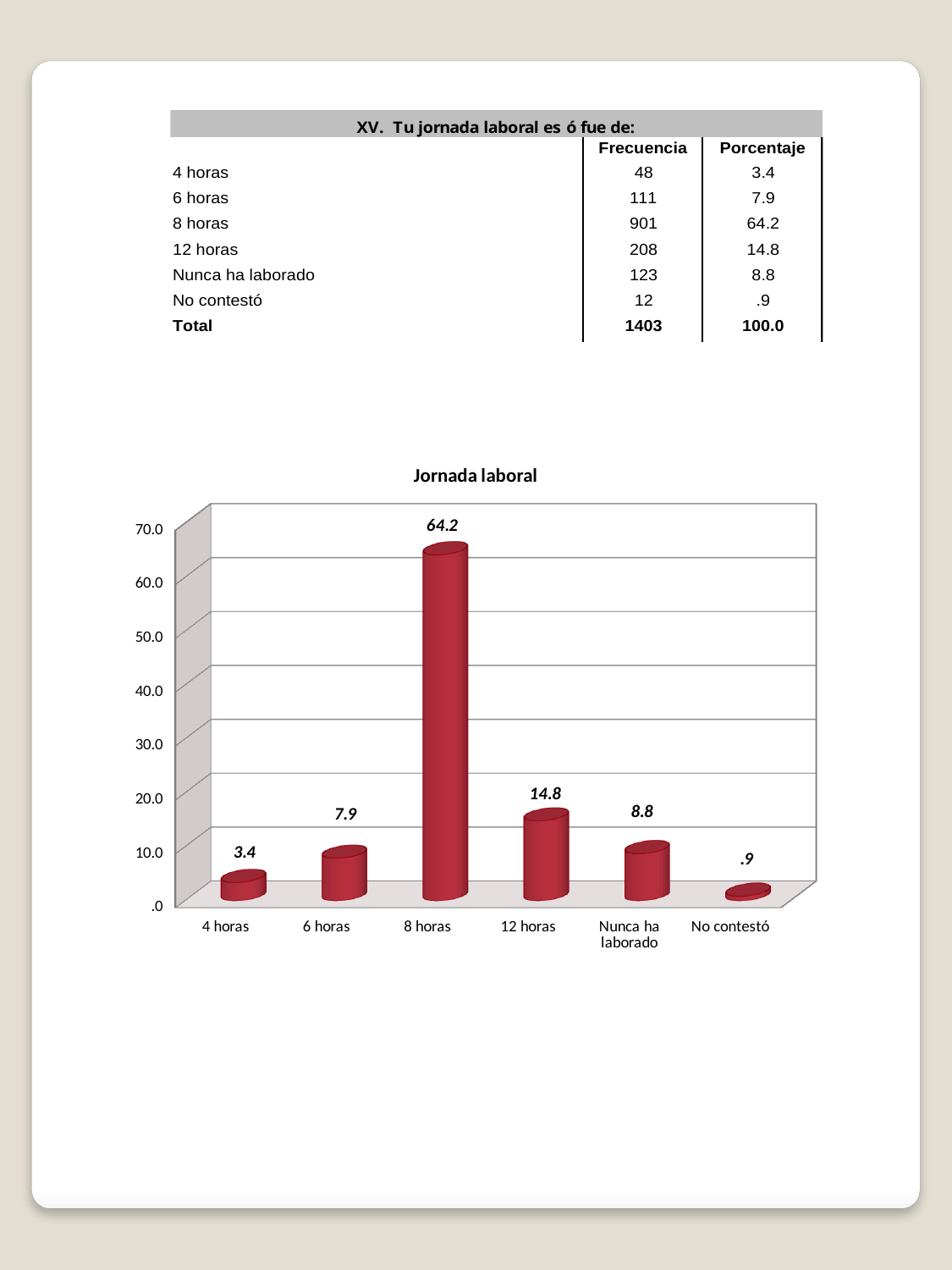
What is the value for Nunca ha laborado in the Jornada laboral chart? 8.8 Which category has the lowest value in the Jornada laboral chart? No contestó Is the value for 8 horas in the Jornada laboral chart greater or less than 60.0? greater How many categories are shown in the Jornada laboral chart? 6 What is the value for No contestó in the Jornada laboral chart? .9 What kind of chart is the Jornada laboral chart? bar chart What is the difference between the values for 6 horas and 4 horas in the Jornada laboral chart? 4.5 What is the difference between the values for 8 horas and 12 horas in the Jornada laboral chart? 49.4 What is the value for 12 horas in the Jornada laboral chart? 14.8 Which category has the highest value in the Jornada laboral chart? 8 horas Which is larger in the Jornada laboral chart, the value for 12 horas or the value for Nunca ha laborado? 12 horas What is the value for 8 horas in the Jornada laboral chart? 64.2